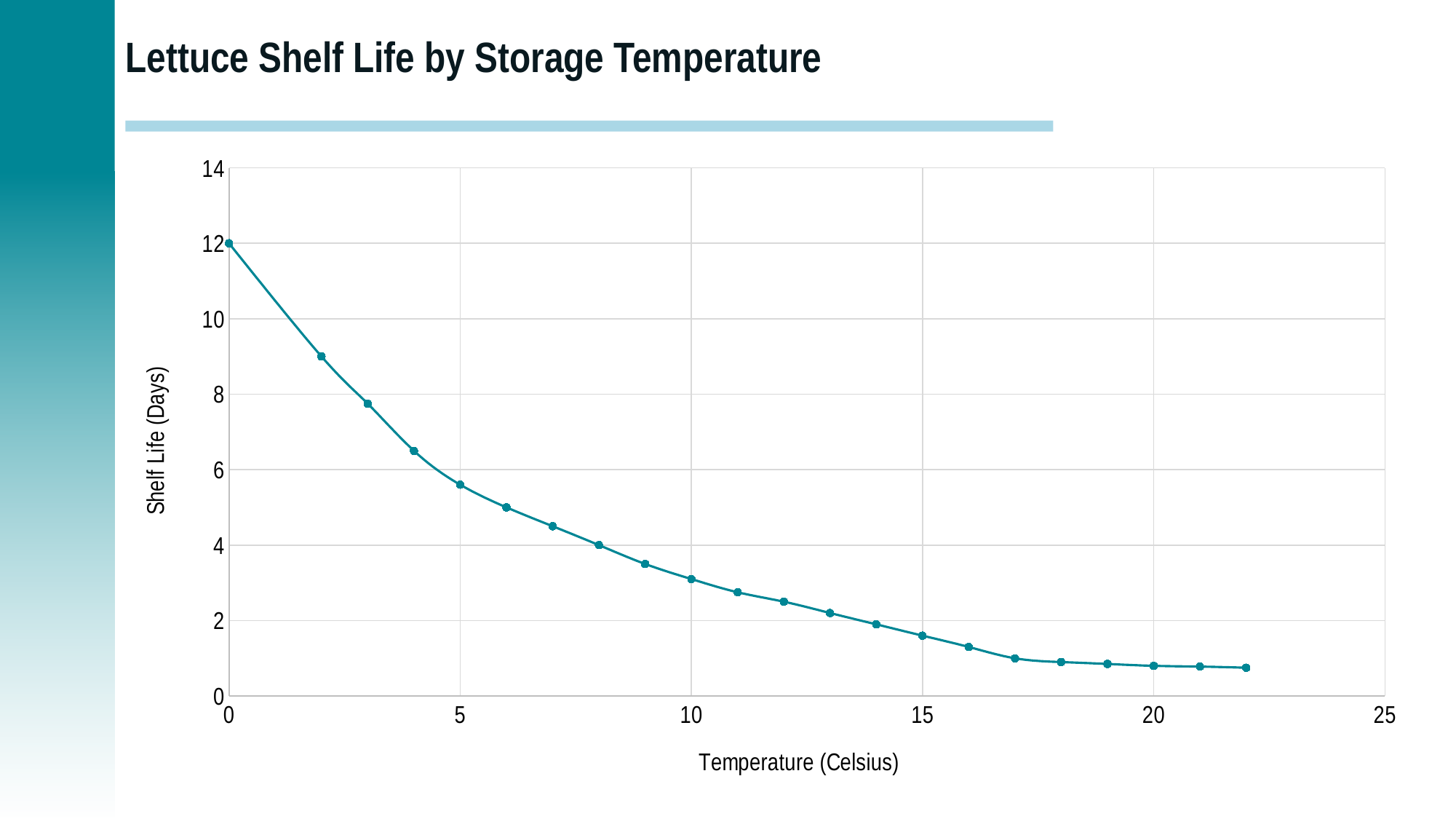
Is the shelf life at 2 Celsius greater or less than 8 days? greater Is the shelf life at 5 Celsius greater or less than 6 days? less Is the shelf life at 12 Celsius greater or less than 2 days? greater What is the shelf life in days at a storage temperature of 8 Celsius? 4 What kind of chart is shown on the slide? line chart What is the shelf life in days at a storage temperature of 0 Celsius? 12 What is the title of the chart? Lettuce Shelf Life by Storage Temperature Does shelf life rise or fall as temperature increases along the x axis? fall At which storage temperature is the shelf life highest? 0 What is the label of the y axis? Shelf Life (Days) Which has the longer shelf life: storage at 3 Celsius or at 10 Celsius? 3 Celsius